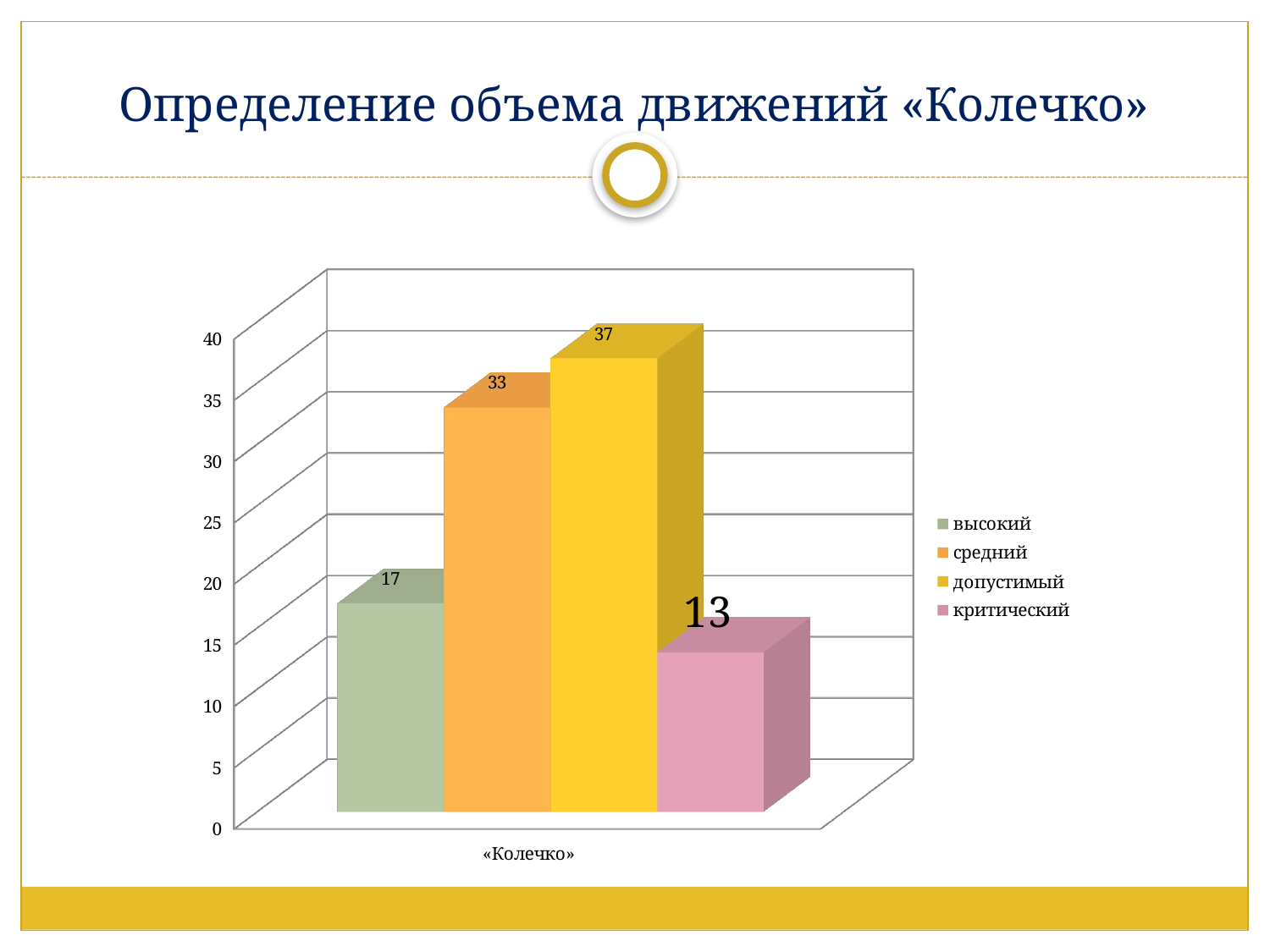
Which series has the highest value? допустимый What is the difference between the values for «высокий» and «критический»? 4 What is the difference between the values for «допустимый» and «средний»? 4 What kind of chart is shown on the slide? bar chart What is the value for the series «высокий»? 17 Which is larger, the value for «высокий» or the value for «средний»? средний How many series does the legend list? 4 What is the value for the series «допустимый»? 37 What is the value for the series «критический»? 13 Which series has the lowest value? критический What is the value for the series «средний»? 33 What is the category label shown on the x axis? «Колечко»